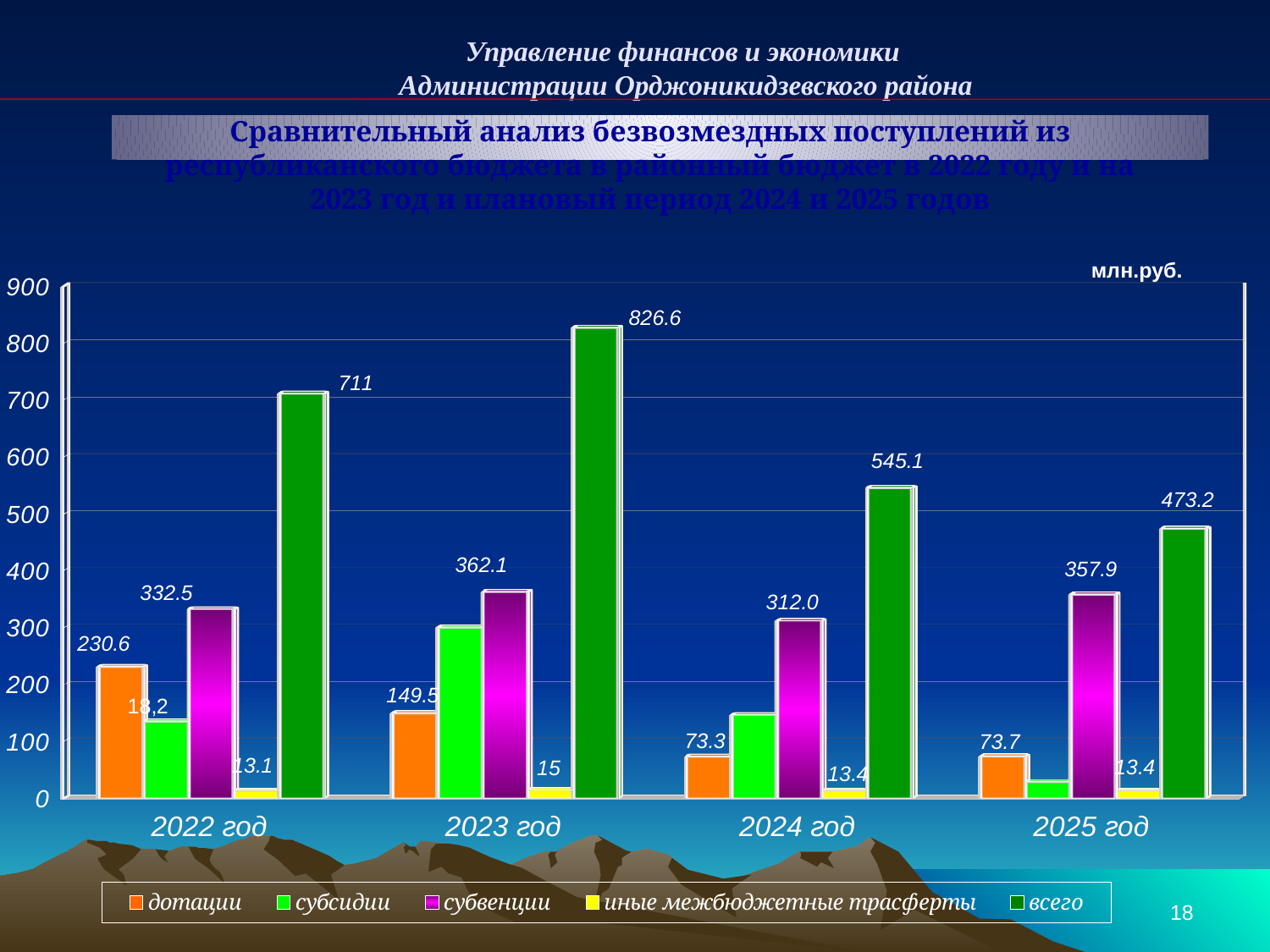
What is the value of всего for 2023 год? 826.6 Is the value of субсидии for 2023 год greater or less than 200? greater In which year is the всего value the highest? 2023 год What kind of chart is shown on the slide? bar chart What is the value of иные межбюджетные трансферты for 2023 год? 15 In which year is the всего value the lowest? 2025 год What unit is indicated above the chart? млн.руб. What is the difference between the всего values for 2023 год and 2022 год? 115.6 What is the value of дотации for 2022 год? 230.6 How many series does the legend list? 5 Which is larger: дотации in 2022 год or дотации in 2023 год? 2022 год How many year groups are shown on the x axis? 4